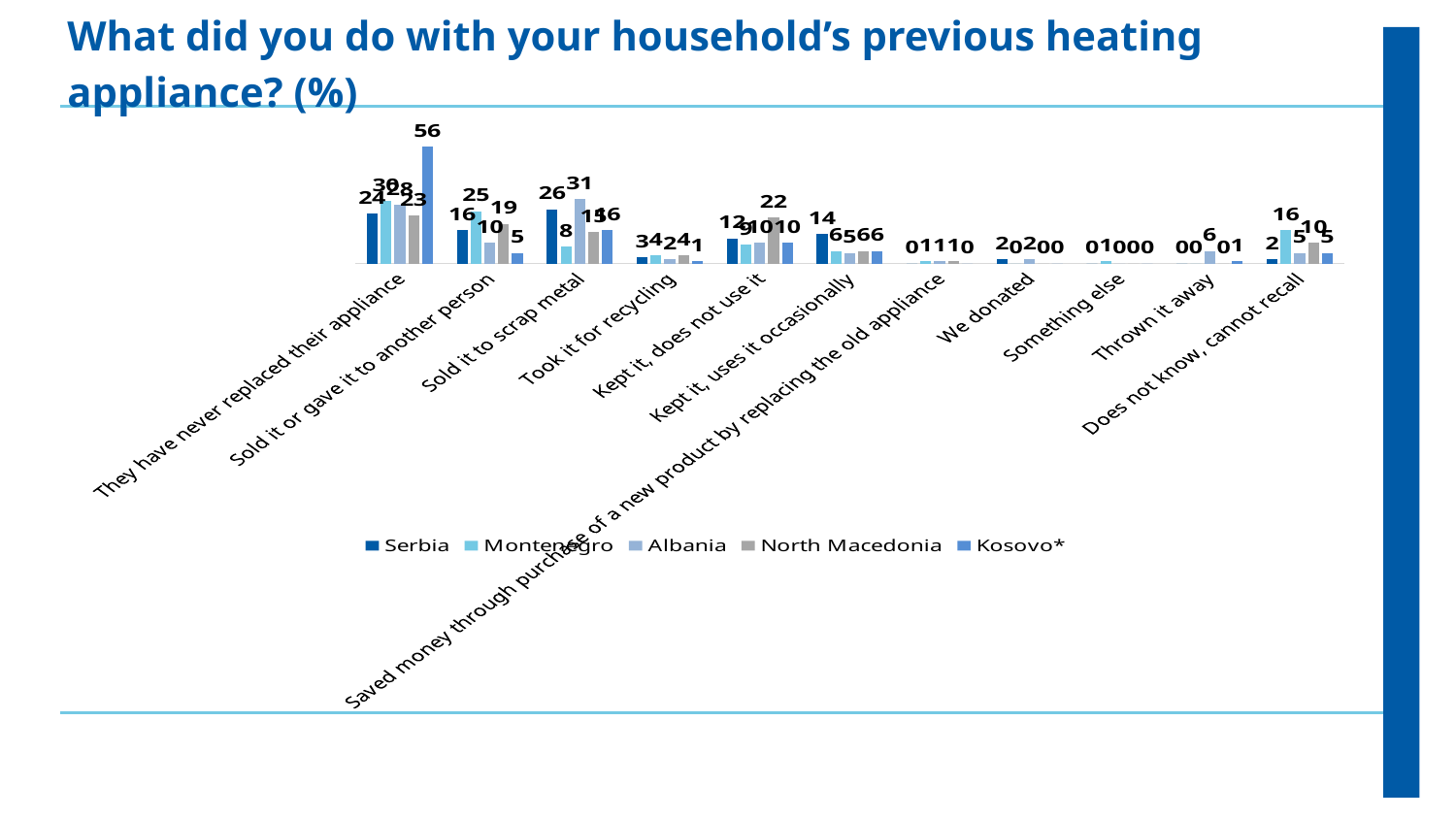
What is the value for North Macedonia in the category 'Kept it, does not use it'? 22 How many categories are shown on the x axis? 11 How many series does the legend list? 5 What is the difference between Kosovo* and Serbia in the category 'They have never replaced their appliance'? 32 Which country has the highest value in the category 'They have never replaced their appliance'? Kosovo* In the category 'Sold it to scrap metal', which is larger: Serbia or Montenegro? Serbia What kind of chart is shown on the slide? bar chart What is the value for Serbia in the category 'Kept it, uses it occasionally'? 14 What is the value for Kosovo* in the category 'They have never replaced their appliance'? 56 What is the value for Montenegro in the category 'Sold it or gave it to another person'? 25 What is the value for Montenegro in the category 'Does not know, cannot recall'? 16 What is the title of the chart? What did you do with your household's previous heating appliance? (%)